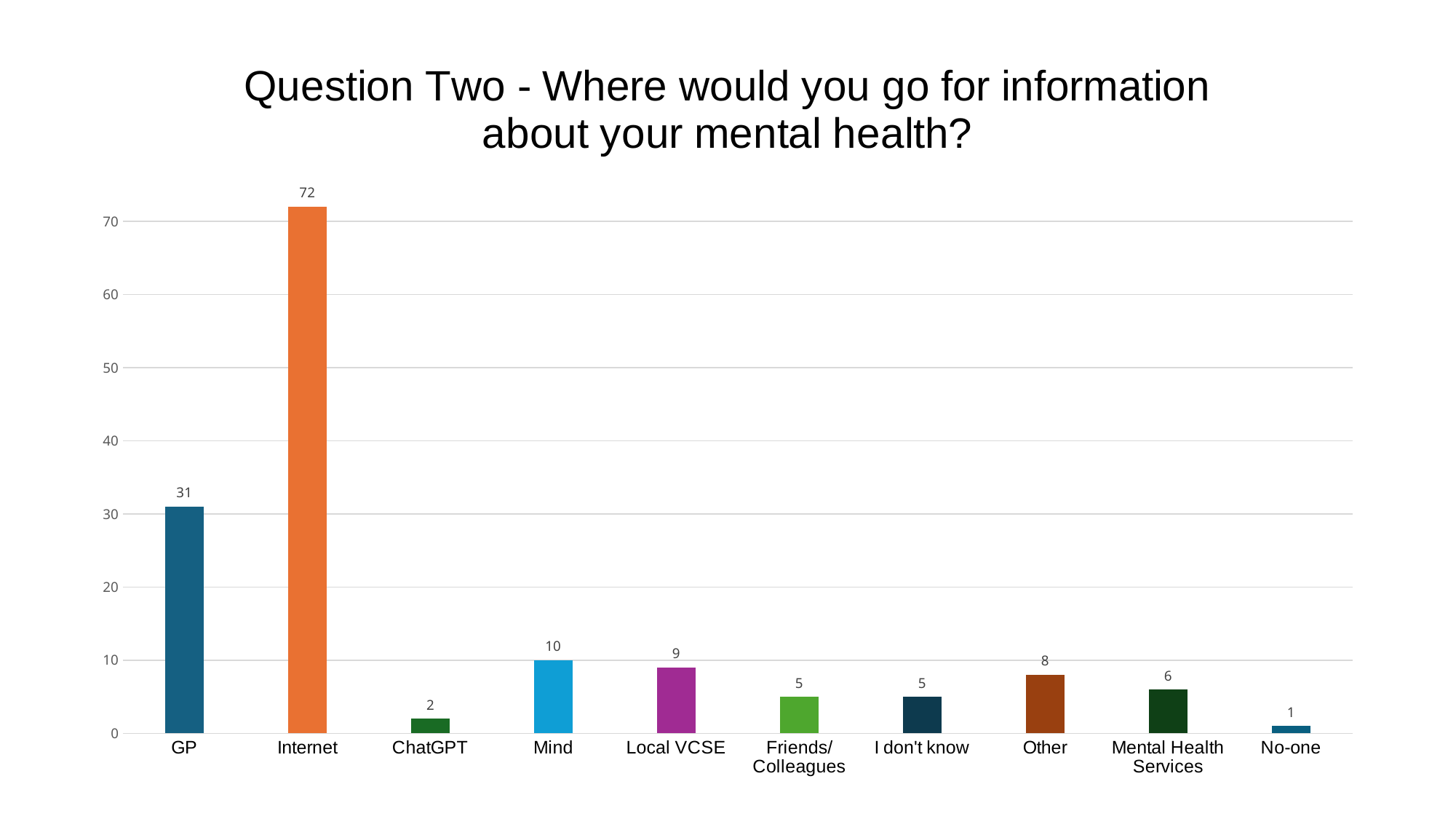
What kind of chart is shown on the slide? bar chart What is the value for GP? 31 How many categories are shown on the x axis? 10 What is the value for Local VCSE? 9 Is the value for GP greater or less than 40? less Which category has the lowest value? No-one What is the value for Mental Health Services? 6 Which is larger, the value for Mind or the value for Other? Mind Which category has the highest value? Internet What is the difference between the values for Internet and GP? 41 What is the value for Internet? 72 What is the title of the chart? Question Two - Where would you go for information about your mental health?